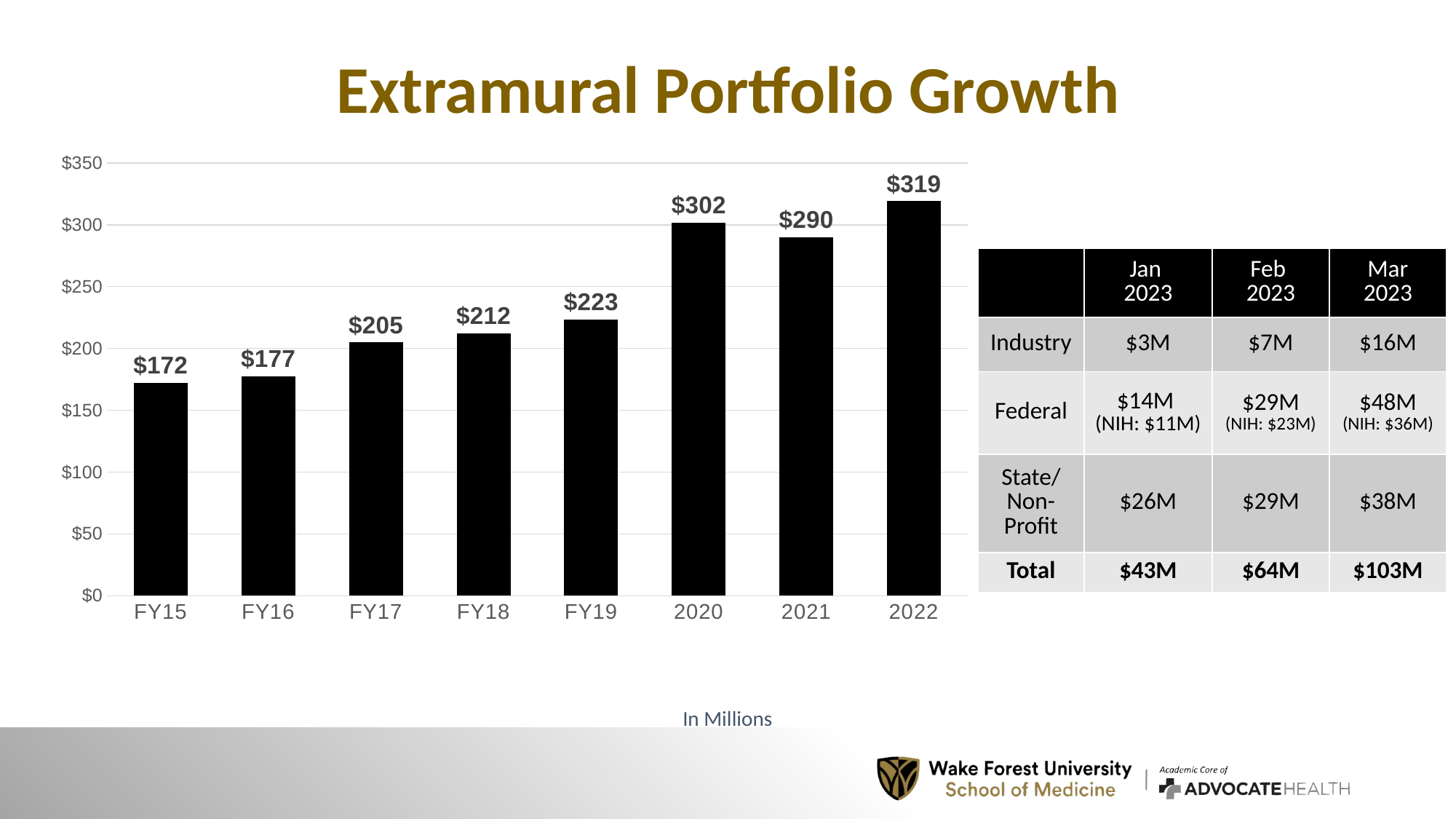
What is the difference between the values for 2020 and 2021? $12 Which category has the lowest value? FY15 Which is larger, the value for 2020 or the value for 2021? 2020 What kind of chart is shown on the slide? bar chart Is the value for FY18 greater or less than $200? greater Which category has the highest value? 2022 How many categories are shown on the x axis? 8 What is the difference between the values for 2022 and FY15? $147 What is the value for FY19? $223 What is the value for FY15? $172 What is the value for 2020? $302 What is the title of the chart? Extramural Portfolio Growth